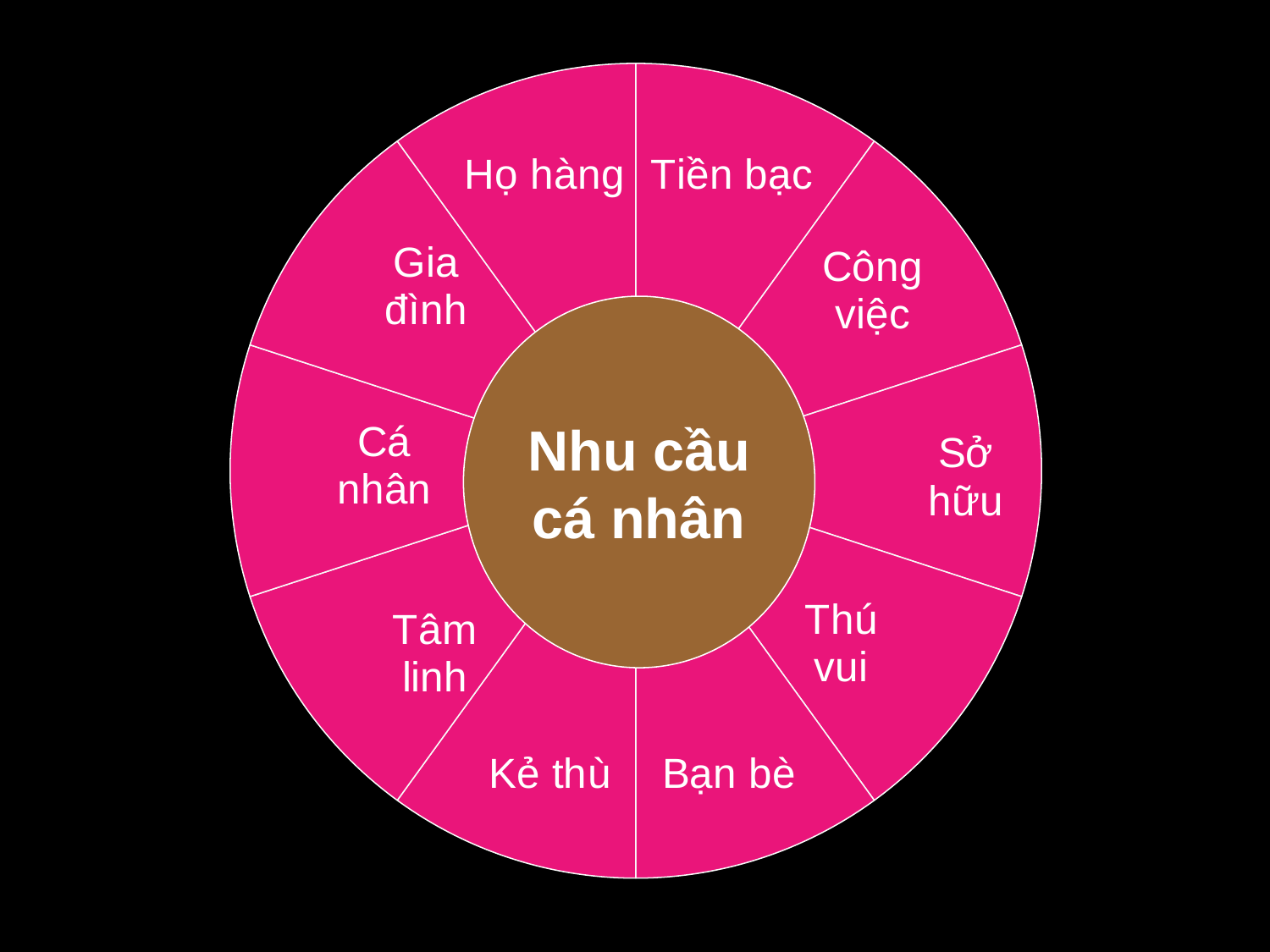
Which segment is labelled immediately to the left of the bottom centre of the ring? Kẻ thù What kind of chart is shown on the slide? Doughnut chart How many segments does the ring chart have? 10 Which segment is labelled immediately to the right of the bottom centre of the ring? Bạn bè Which segment sits at the far right of the ring? Sở hữu Which segment is labelled immediately to the right of the top centre of the ring? Tiền bạc What colour are the segments of the ring? Pink Which segment is labelled immediately to the left of the top centre of the ring? Họ hàng Which segment sits at the far left of the ring? Cá nhân What text is written in the centre of the chart? Nhu cầu cá nhân